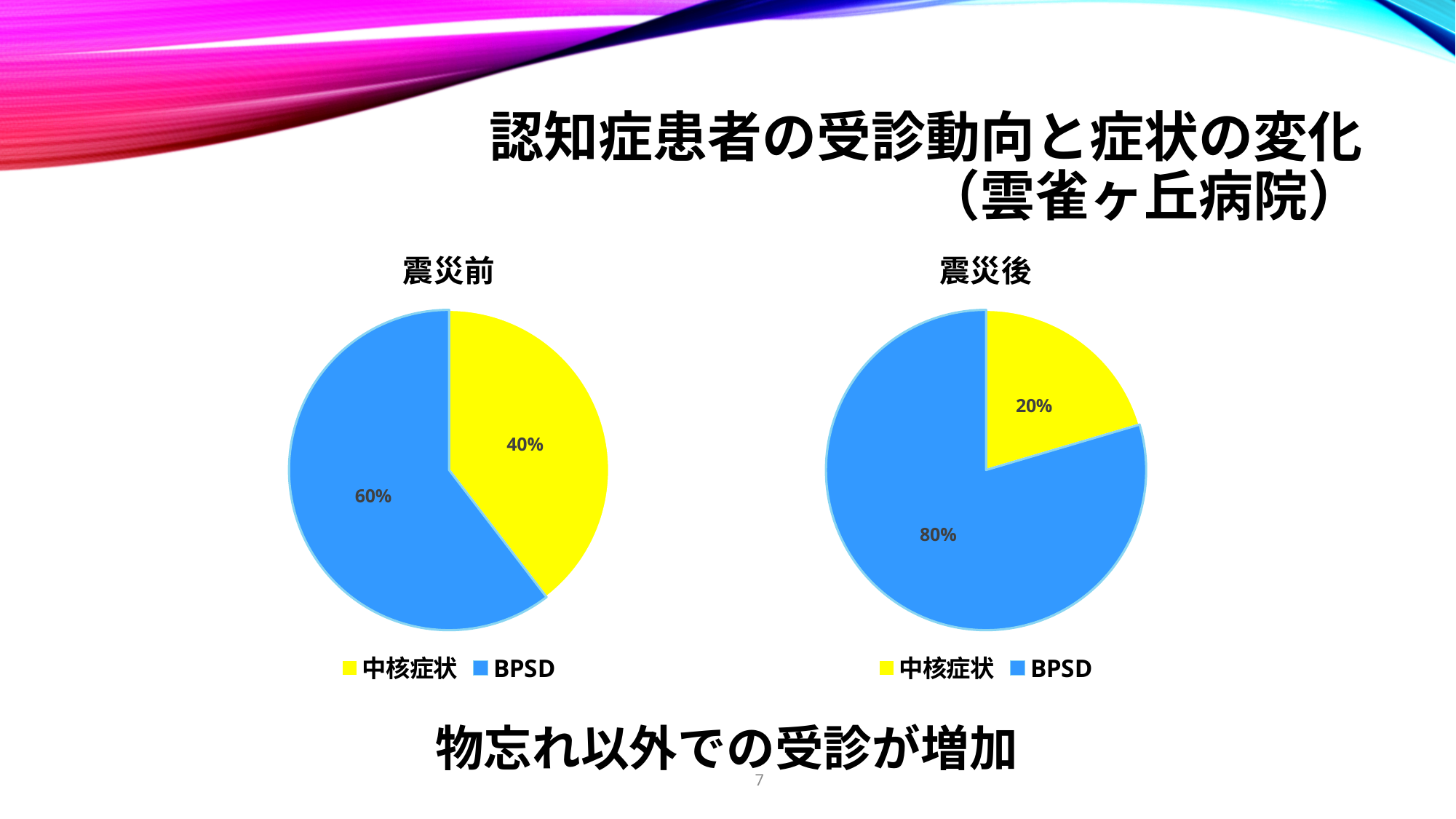
In the 震災後 pie chart, what share does BPSD have? 80% In the 震災前 pie chart, which category has the smallest slice? 中核症状 How many slices does the 震災前 pie chart have? 2 In the 震災後 pie chart, what colour is the BPSD slice? Blue What kind of chart is the 震災前 chart? Pie chart In the 震災後 pie chart, what share does 中核症状 have? 20% How many entries does the legend of the 震災後 chart list? 2 Is the 中核症状 share larger in the 震災前 chart or the 震災後 chart? 震災前 In the 震災前 pie chart, what share does BPSD have? 60% In the 震災後 pie chart, what is the difference between the BPSD share and the 中核症状 share? 60% In the 震災後 pie chart, which category has the largest slice? BPSD In the 震災前 pie chart, what share does 中核症状 have? 40%